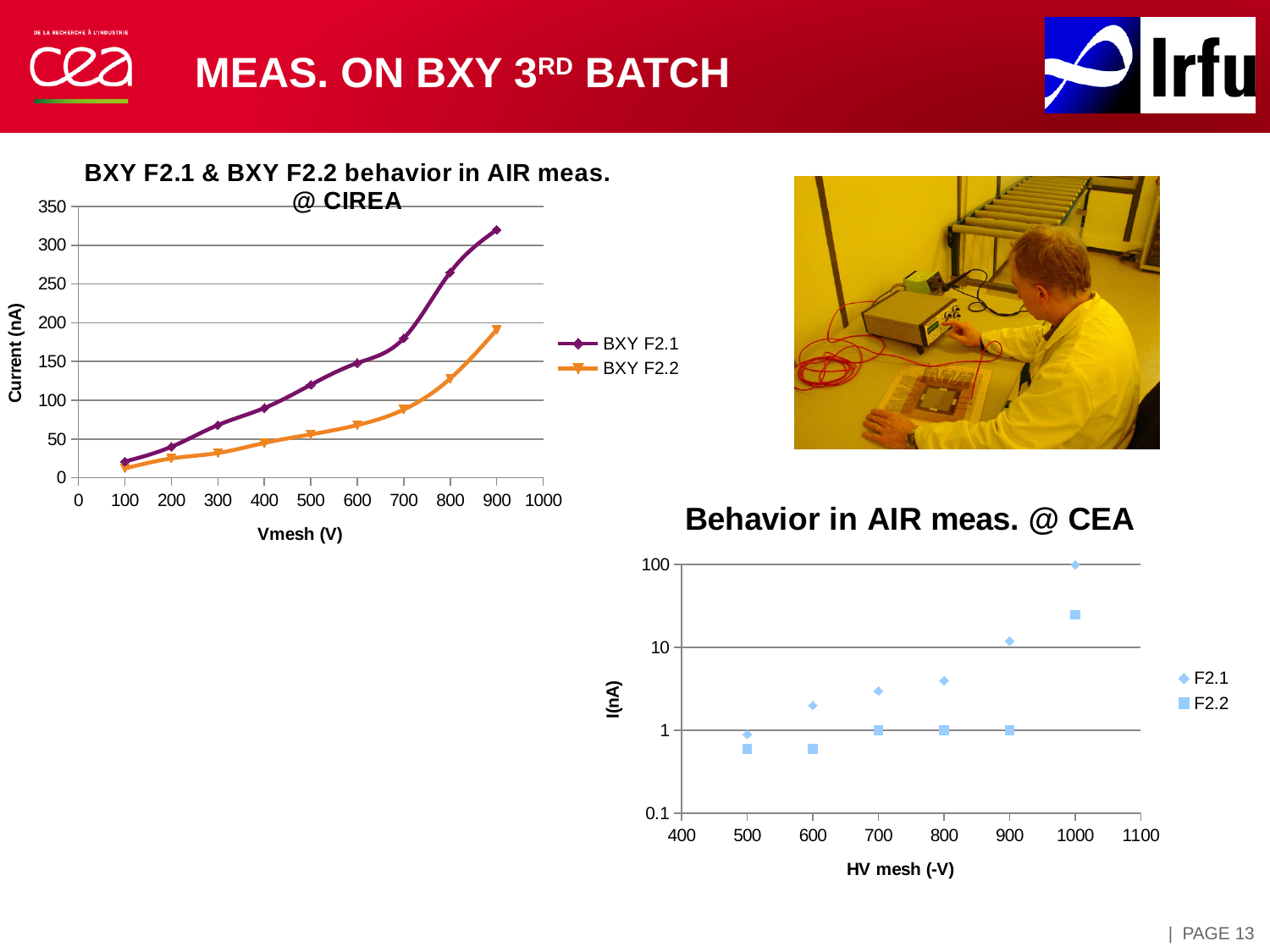
In the 'BXY F2.1 & BXY F2.2 behavior in AIR meas. @ CIREA' chart, which series has the higher current at 900 V? BXY F2.1 In the 'BXY F2.1 & BXY F2.2 behavior in AIR meas. @ CIREA' chart, is the current for BXY F2.1 at 900 V greater or less than 300? greater What is the y-axis label of the 'BXY F2.1 & BXY F2.2 behavior in AIR meas. @ CIREA' chart? Current (nA) In the 'Behavior in AIR meas. @ CEA' chart, is the value for F2.2 at 500 V greater or less than 1? less How many series does the legend of the 'Behavior in AIR meas. @ CEA' chart list? 2 In the 'BXY F2.1 & BXY F2.2 behavior in AIR meas. @ CIREA' chart, is the current for BXY F2.2 at 600 V greater or less than 100? less In the 'Behavior in AIR meas. @ CEA' chart, which series has the higher value at 900 V? F2.1 What is the x-axis label of the 'Behavior in AIR meas. @ CEA' chart? HV mesh (-V) In the 'BXY F2.1 & BXY F2.2 behavior in AIR meas. @ CIREA' chart, does the current for BXY F2.1 rise or fall as Vmesh increases? rise What type of chart is the 'BXY F2.1 & BXY F2.2 behavior in AIR meas. @ CIREA' chart? line chart How many series does the legend of the 'BXY F2.1 & BXY F2.2 behavior in AIR meas. @ CIREA' chart list? 2